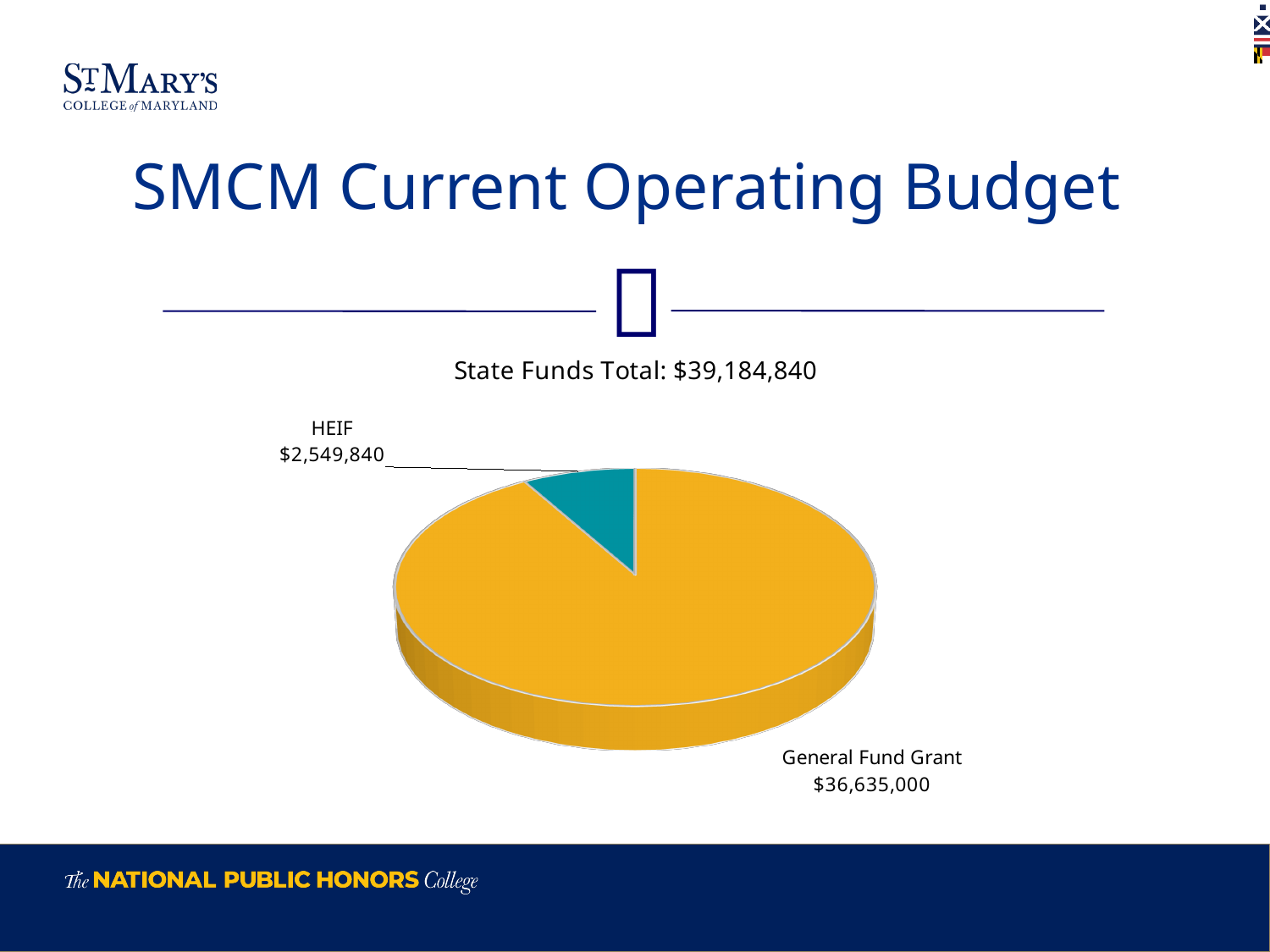
What colour is the General Fund Grant slice? Yellow/gold What is the difference between the General Fund Grant and HEIF values? $34,085,160 How many slices does the pie chart have? 2 What is the value of the HEIF slice? $2,549,840 What is the State Funds Total shown above the chart? $39,184,840 What kind of chart is shown on the slide? Pie chart Which slice of the pie is the smallest? HEIF What is the value of the General Fund Grant slice? $36,635,000 What is the title of the slide containing the chart? SMCM Current Operating Budget Which slice of the pie is the largest? General Fund Grant Which is larger, the General Fund Grant or HEIF? General Fund Grant